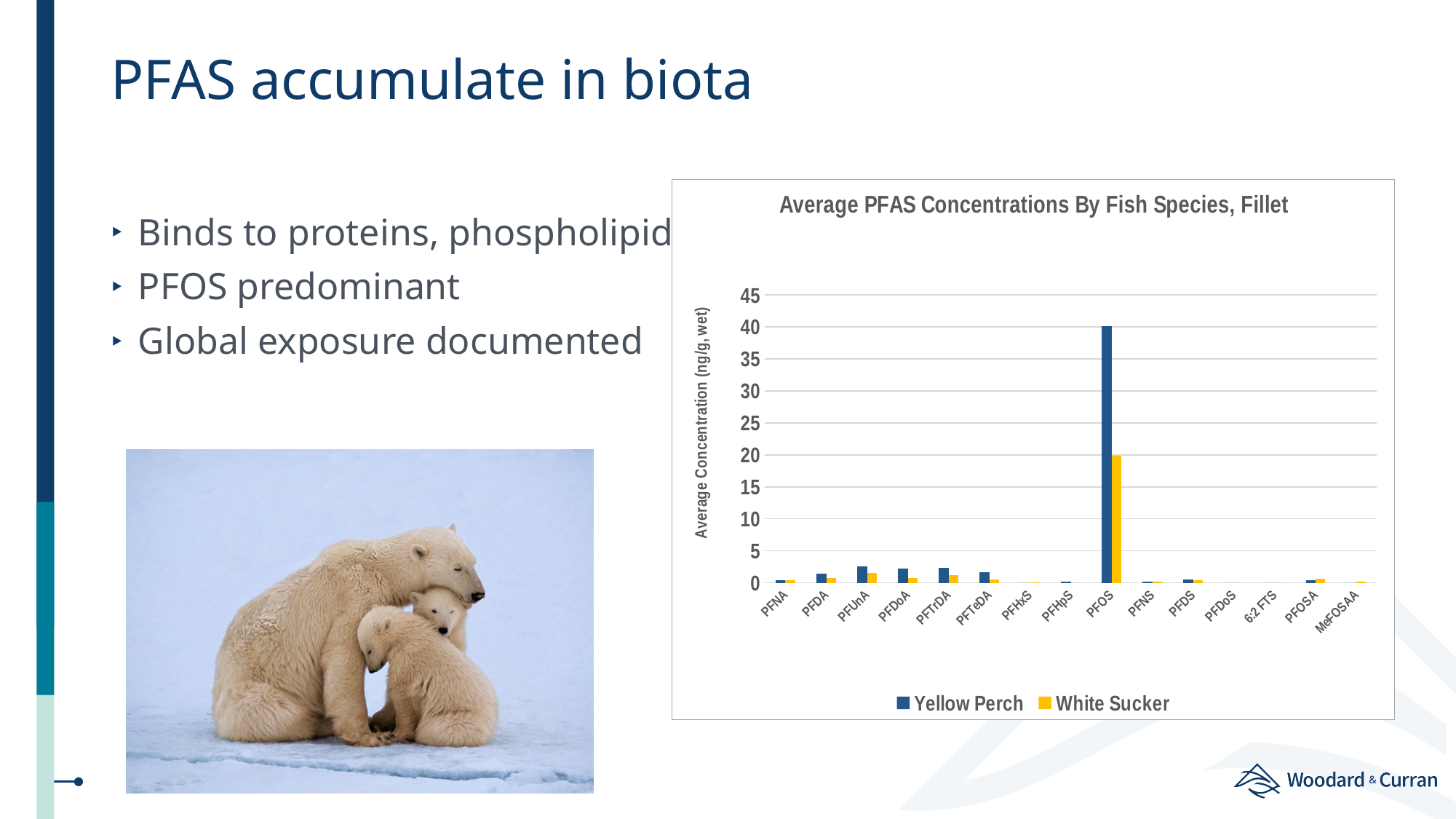
What type of chart is shown on the slide? bar chart Is the Yellow Perch value for PFOS greater or less than 35? greater What is the title of the chart? Average PFAS Concentrations By Fish Species, Fillet For PFOS, which species has the larger average concentration, Yellow Perch or White Sucker? Yellow Perch Is the Yellow Perch value for PFUnA greater or less than 5? less Which compound has the highest average concentration for Yellow Perch? PFOS What is the label of the y axis of the chart? Average Concentration (ng/g, wet) Is the White Sucker value for PFOS greater or less than 25? less How many series does the chart legend list? 2 Which compound has the highest average concentration for White Sucker? PFOS How many PFAS compounds (categories) are shown on the x axis of the chart? 15